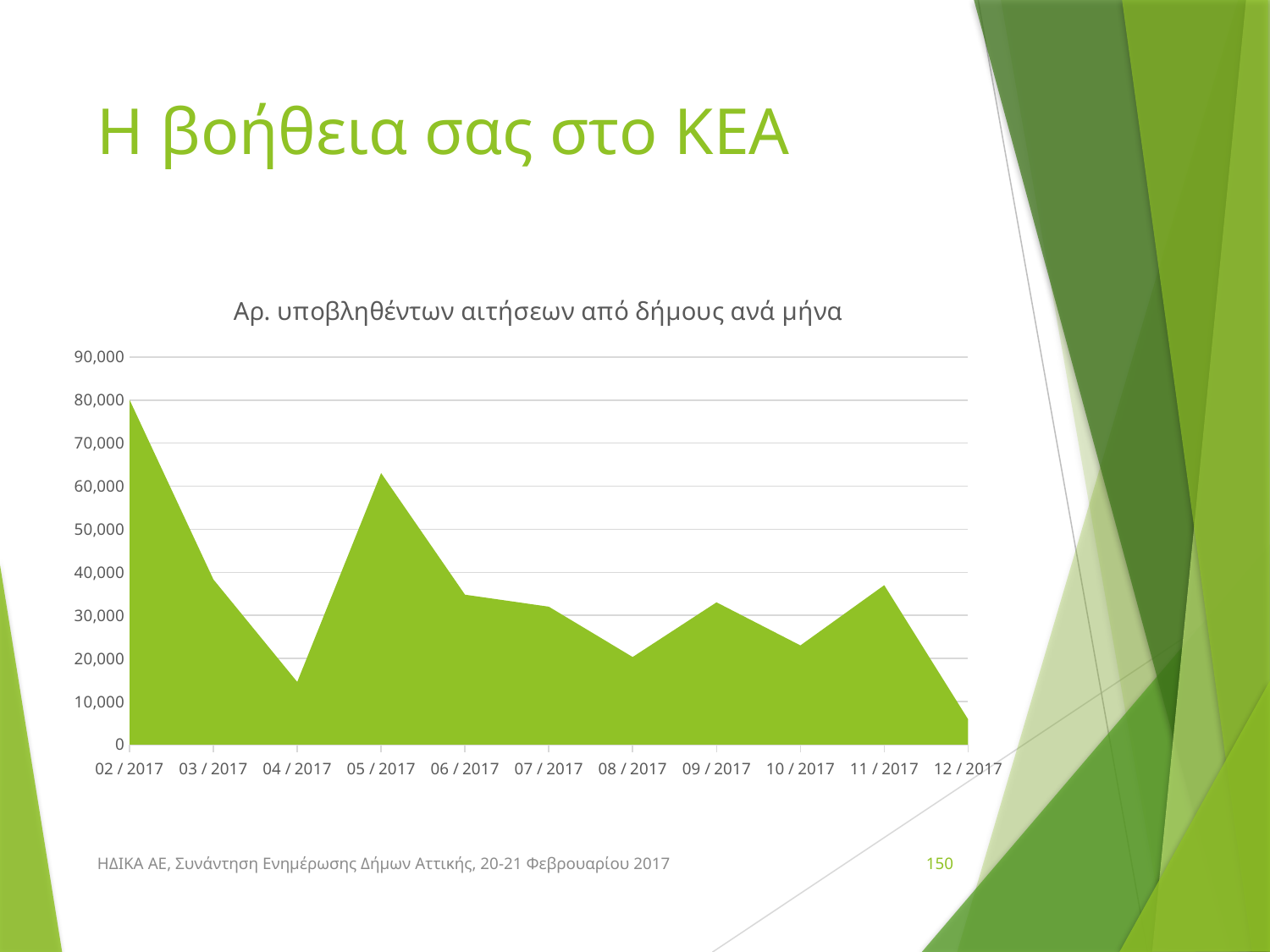
How many months are plotted on the x axis of the chart? 11 Is the value for 05 / 2017 greater or less than 60,000? greater Which month has the lowest number of submitted applications? 12 / 2017 Is the value for 04 / 2017 greater or less than 20,000? less Which month has the larger value, 05 / 2017 or 03 / 2017? 05 / 2017 What is the title of the chart? Αρ. υποβληθέντων αιτήσεων από δήμους ανά μήνα Which month has the larger value, 08 / 2017 or 09 / 2017? 09 / 2017 What kind of chart is shown on the slide? area chart Is the value for 12 / 2017 greater or less than 10,000? less Which month has the highest number of submitted applications? 02 / 2017 Overall, do the values rise or fall from 02 / 2017 to 12 / 2017? fall